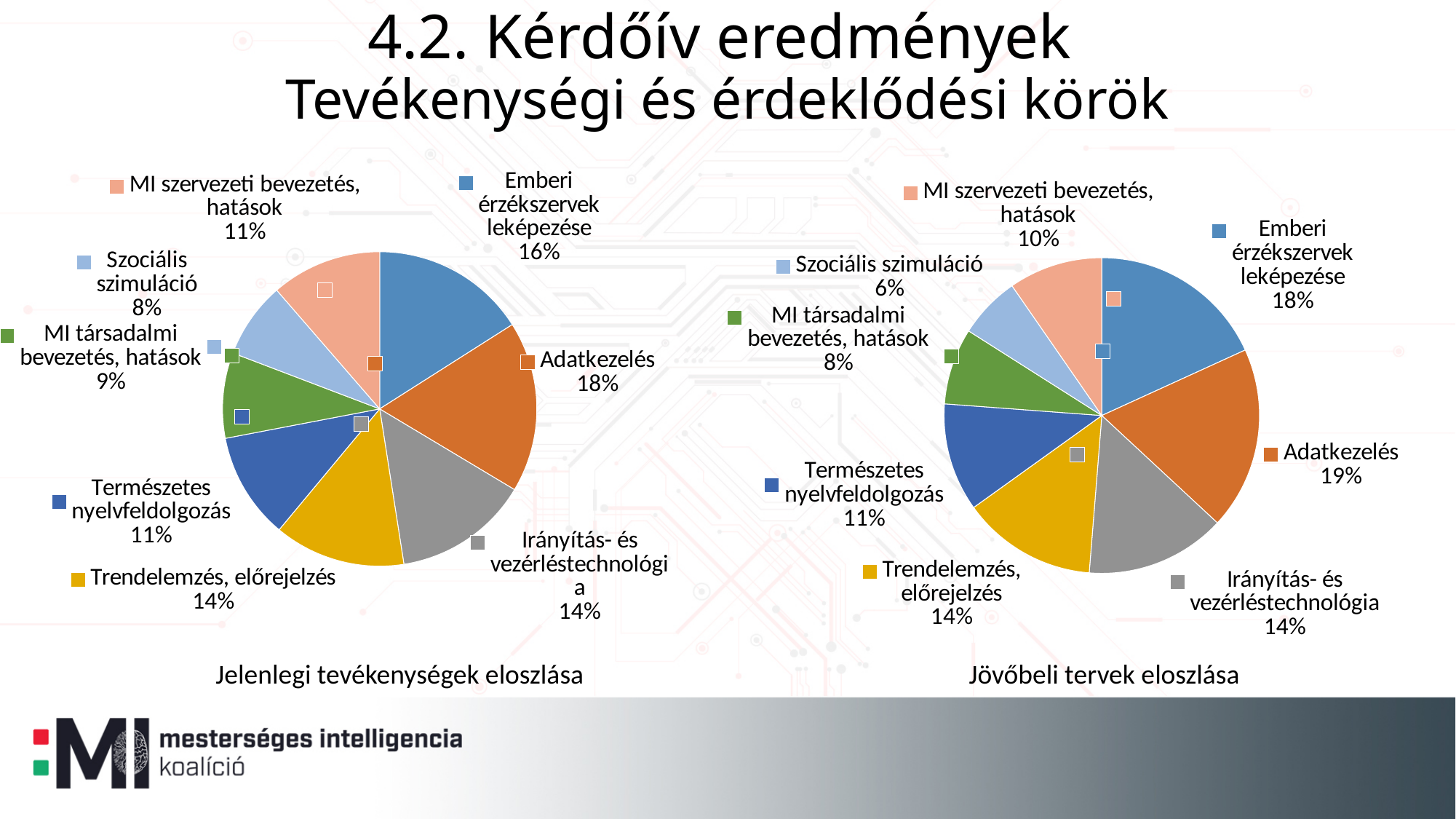
In the 'Jövőbeli tervek eloszlása' chart, what share does Adatkezelés have? 19% In the 'Jelenlegi tevékenységek eloszlása' chart, which category has the largest share? Adatkezelés What kind of chart is the 'Jelenlegi tevékenységek eloszlása' chart? pie chart In the 'Jövőbeli tervek eloszlása' chart, what is the difference between the shares of Emberi érzékszervek leképezése and MI szervezeti bevezetés, hatások? 8 percentage points In the 'Jelenlegi tevékenységek eloszlása' chart, which category has the smallest share? Szociális szimuláció How many slices does the 'Jelenlegi tevékenységek eloszlása' pie chart have? 8 In the 'Jelenlegi tevékenységek eloszlása' chart, what share does Adatkezelés have? 18% In the 'Jövőbeli tervek eloszlása' chart, which is larger: Természetes nyelvfeldolgozás or Trendelemzés, előrejelzés? Trendelemzés, előrejelzés In the 'Jövőbeli tervek eloszlása' chart, what share does Szociális szimuláció have? 6% In the 'Jelenlegi tevékenységek eloszlása' chart, what share does Emberi érzékszervek leképezése have? 16% In the 'Jövőbeli tervek eloszlása' chart, which category has the smallest share? Szociális szimuláció What is the title of the pie chart on the right side of the slide? Jövőbeli tervek eloszlása